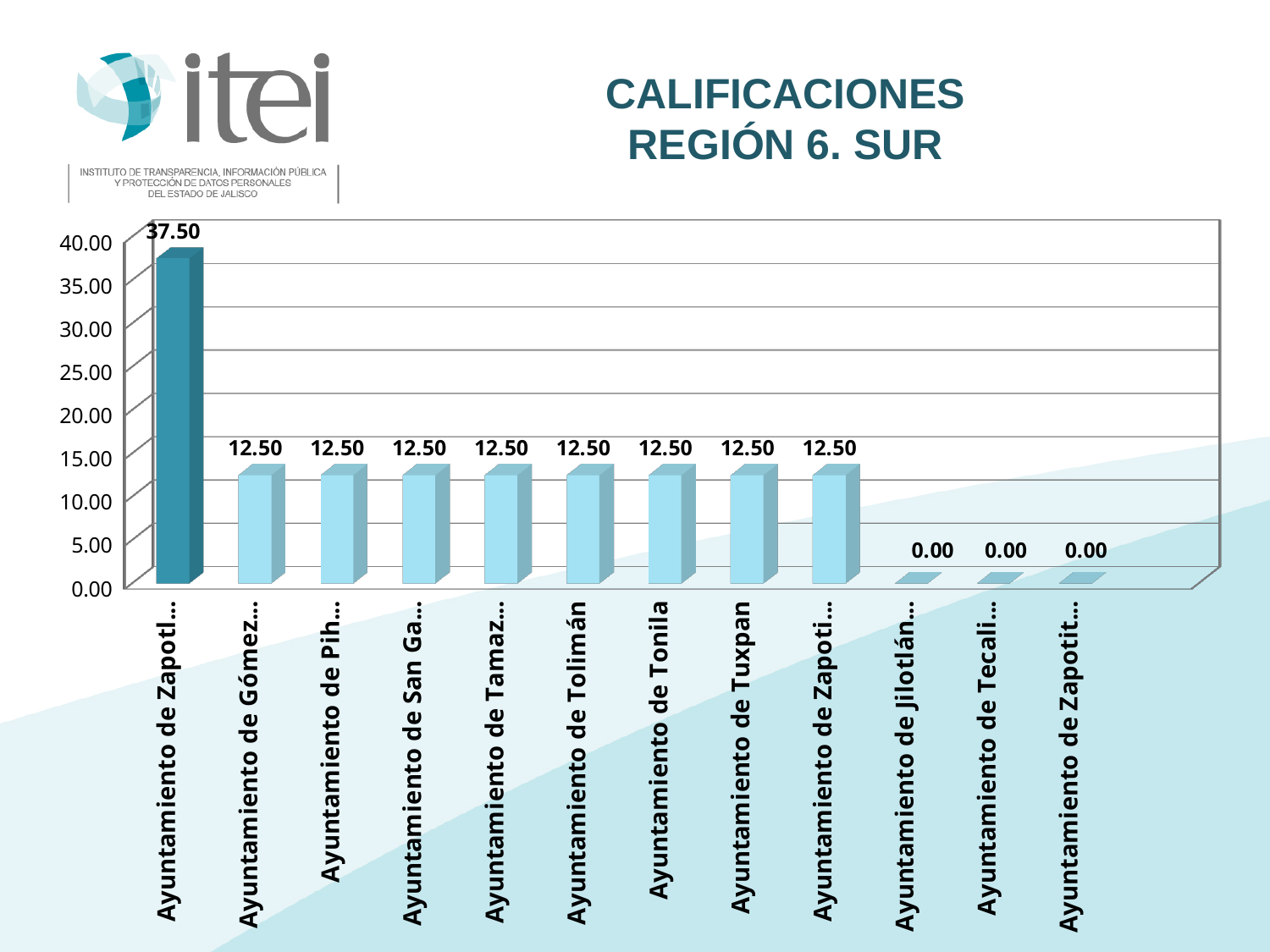
Is the value for Ayuntamiento de Tonila greater or less than 10.00? greater What is the value for Ayuntamiento de Tuxpan? 12.50 What kind of chart is shown on the slide? Bar chart How many bars have a value of 12.50? 8 What is the difference between the highest value (37.50) and the value for Ayuntamiento de Tuxpan? 25.00 How many categories (bars) are shown on the chart? 12 What is the value for Ayuntamiento de Tonila? 12.50 What is the value for Ayuntamiento de Tolimán? 12.50 What is the title of the chart on the slide? CALIFICACIONES REGIÓN 6. SUR What is the lowest value shown on the chart? 0.00 How many bars have a value of 0.00? 3 What is the highest value shown on the chart? 37.50